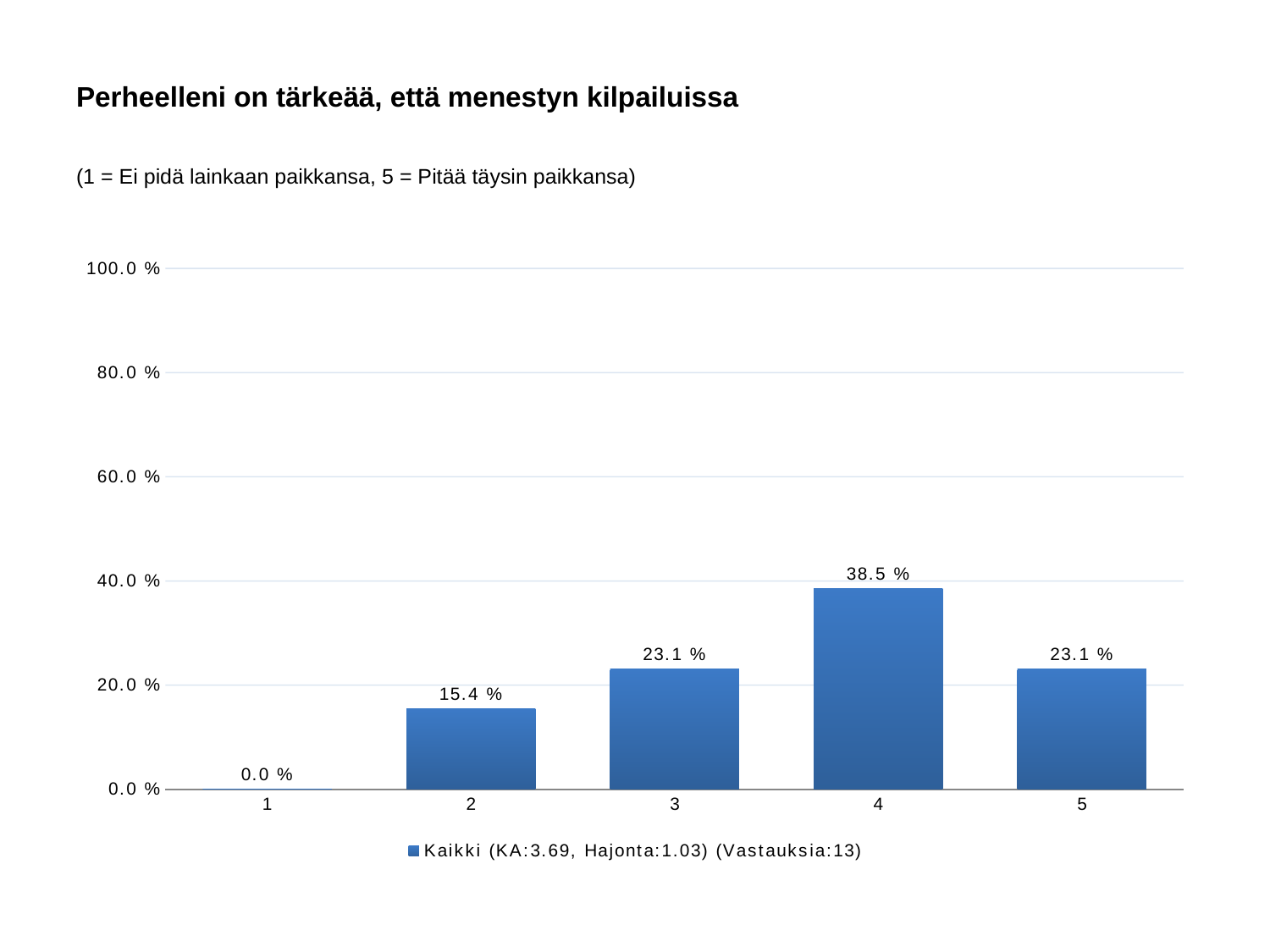
What is the difference between the values for category 4 and category 2? 23.1 % How many categories are shown on the x axis? 5 Is the value for category 4 greater or less than 40.0 %? less What is the value for category 4? 38.5 % Which category has the lowest value? 1 What is the value for category 2? 15.4 % Which is larger, the value for category 3 or the value for category 2? 3 How many series does the legend list? 1 What kind of chart is shown? bar chart Which category has the highest value? 4 What is the value for category 1? 0.0 % What is the title of the slide? Perheelleni on tärkeää, että menestyn kilpailuissa